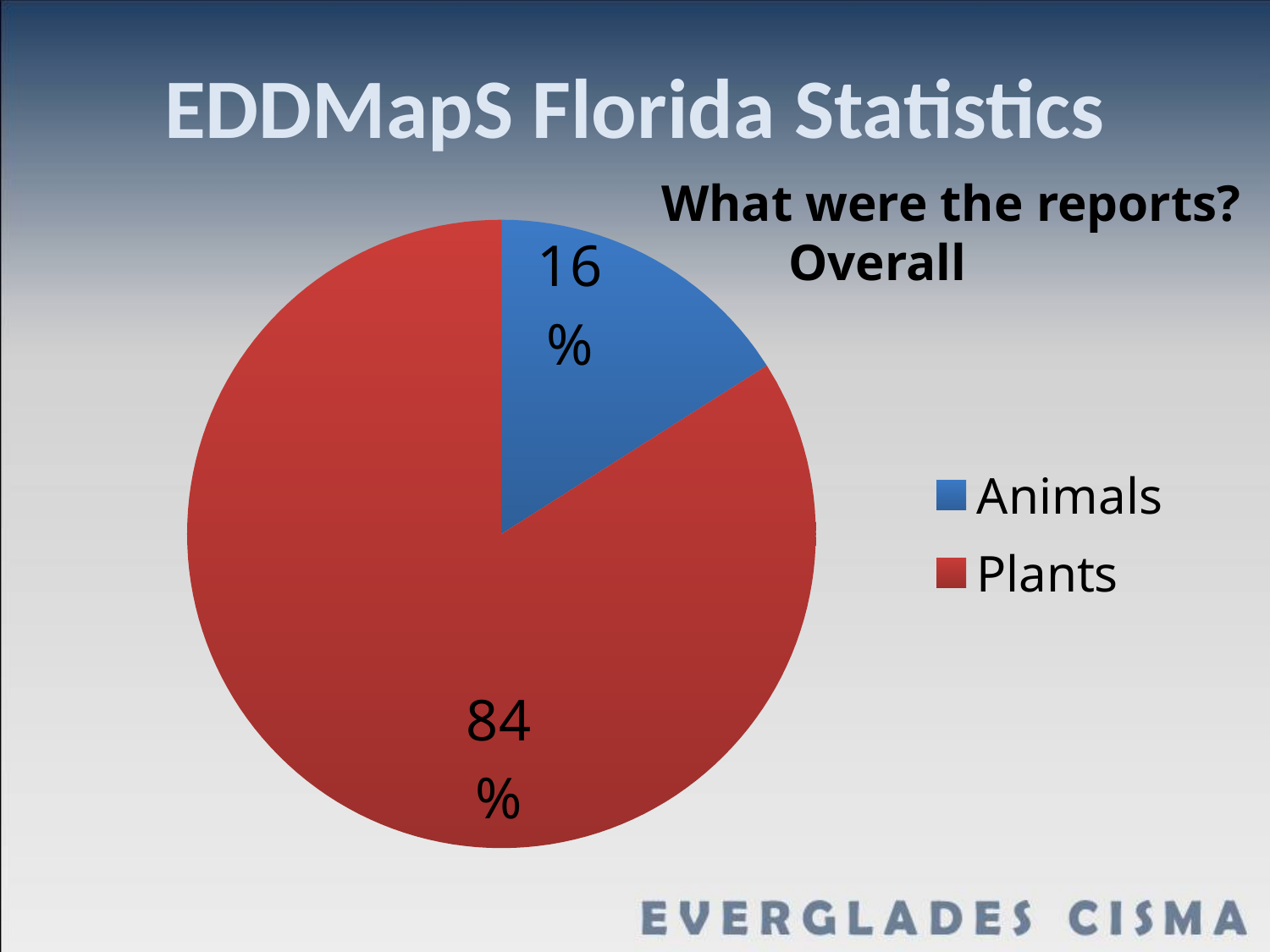
Which category has the smallest share of the pie? Animals What colour is the Animals slice? blue What share of the pie does the Animals slice represent? 16% Which category has the largest share of the pie? Plants What percentage of the reports were Animals? 16% How many slices does the pie chart have? 2 How many percentage points larger is the Plants share than the Animals share? 68 What type of chart is shown on the slide? pie chart What percentage of the reports were Plants? 84% How many entries does the legend list? 2 What is the title of the chart? What were the reports? Overall Which is larger, the share for Animals or the share for Plants? Plants